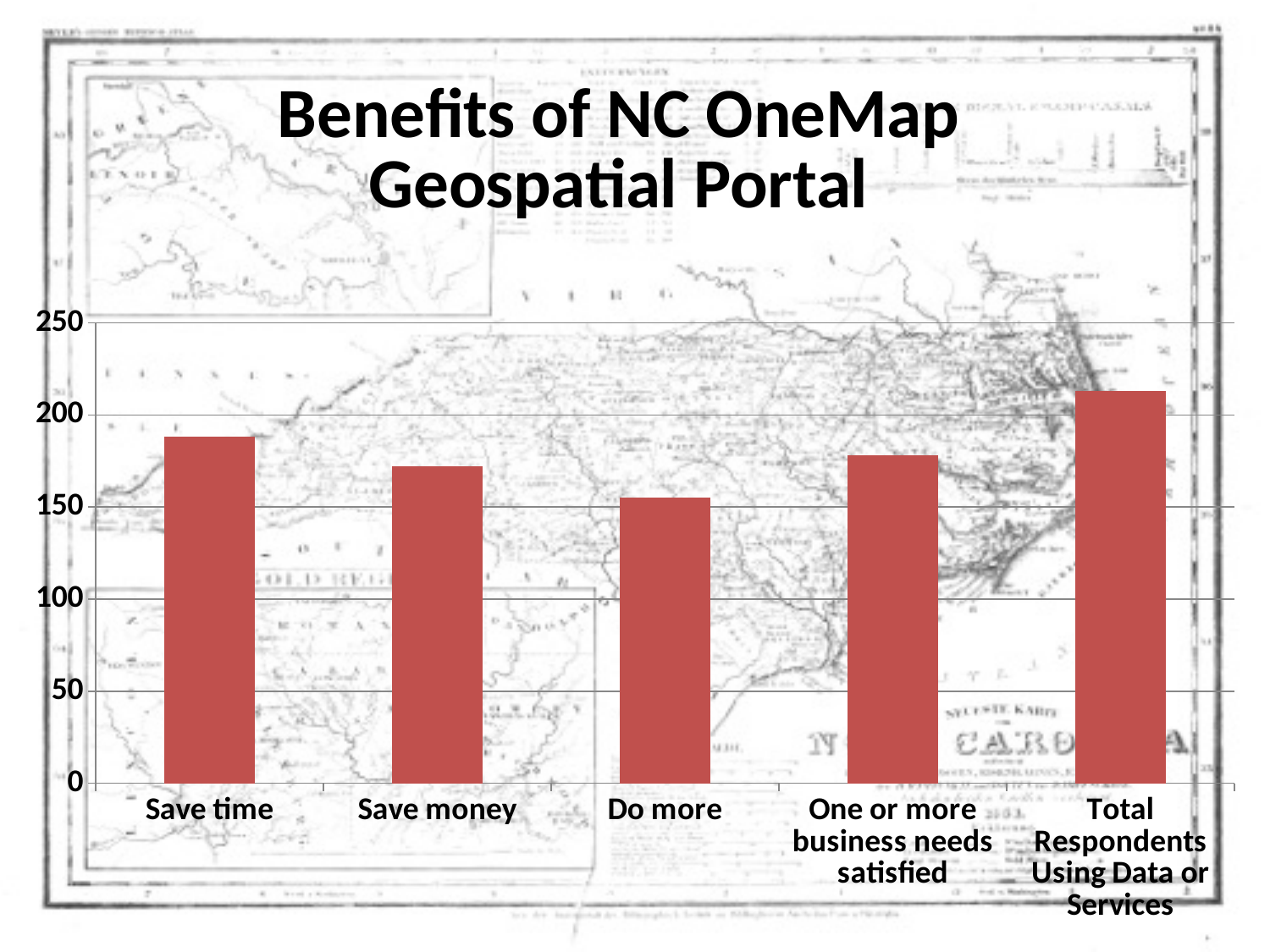
Which category has the highest bar? Total Respondents Using Data or Services What is the title of the chart? Benefits of NC OneMap Geospatial Portal Which is larger, the value for Total Respondents Using Data or Services or the value for Save time? Total Respondents Using Data or Services How many categories are shown on the x axis? 5 Is the value for Save time greater or less than 200? less Which is larger, the value for Save time or the value for Save money? Save time What colour are the bars in the chart? red What kind of chart is shown on the slide? bar chart Is the value for Save money greater or less than 150? greater Which category has the lowest bar? Do more Is the value for Do more greater or less than 200? less